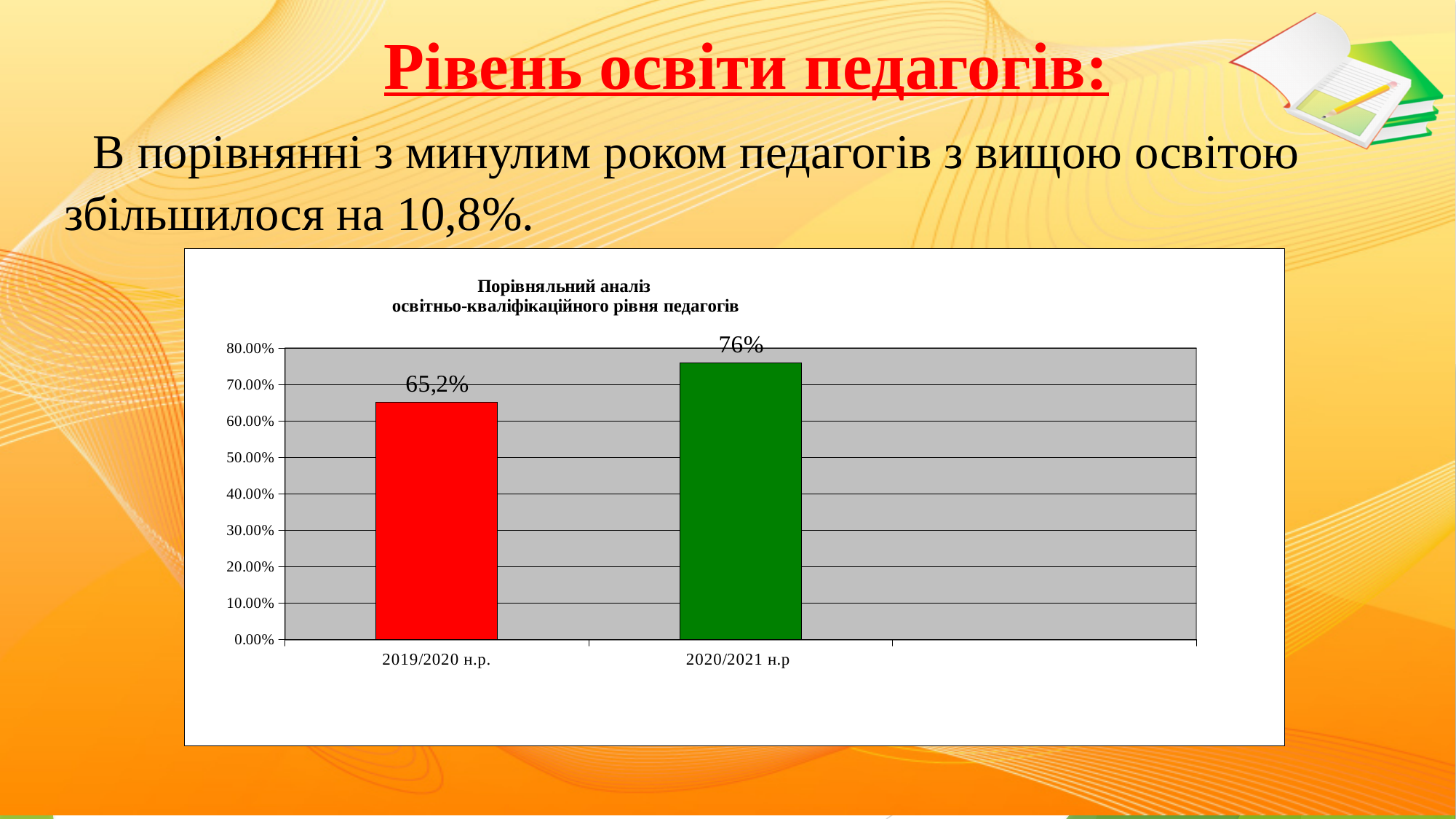
Is the value for 2019/2020 н.р. greater or less than 70.00%? less Do the values rise or fall from 2019/2020 н.р. to 2020/2021 н.р? rise What is the value for 2019/2020 н.р.? 65,2% What kind of chart is shown on the slide? bar chart What is the difference between the values for 2020/2021 н.р and 2019/2020 н.р.? 10,8% What colour is the bar for 2020/2021 н.р? green Is the value for 2020/2021 н.р greater or less than 70.00%? greater Which year has the lowest value? 2019/2020 н.р. Which year has the highest value? 2020/2021 н.р How many categories are shown on the x axis of the chart? 2 What is the value for 2020/2021 н.р? 76% Which is larger, the value for 2019/2020 н.р. or the value for 2020/2021 н.р? 2020/2021 н.р